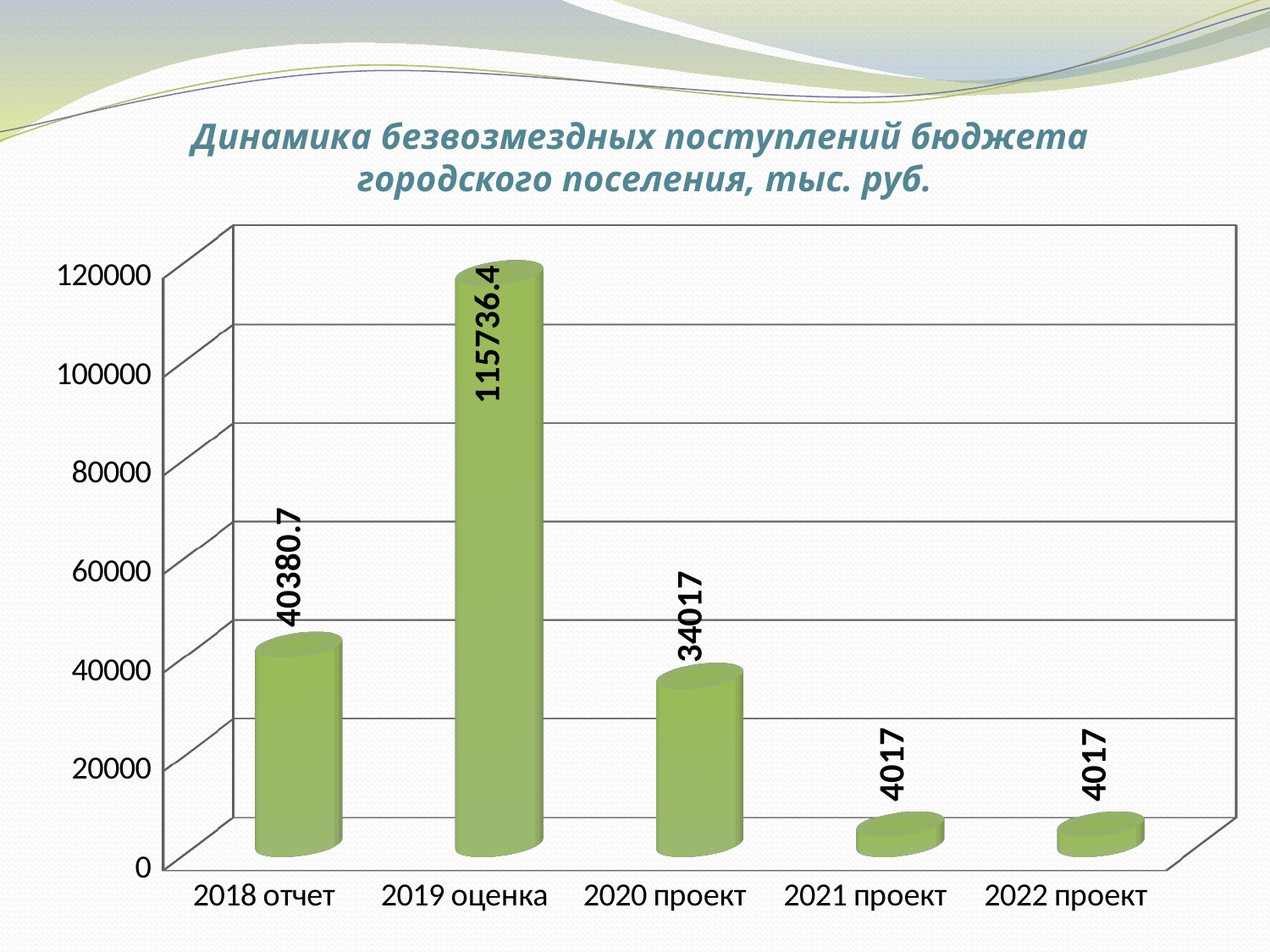
What is the title of the chart? Динамика безвозмездных поступлений бюджета городского поселения, тыс. руб. Which is larger, the value for 2018 отчет or the value for 2020 проект? 2018 отчет Is the value for 2019 оценка greater or less than 100000? greater What is the difference between the values for 2019 оценка and 2018 отчет? 75355.7 What is the value for 2020 проект? 34017 What is the value for 2021 проект? 4017 What is the value for 2018 отчет? 40380.7 What is the value for 2019 оценка? 115736.4 What kind of chart is shown on the slide? bar chart How many categories are shown on the x axis? 5 Which category has the highest value? 2019 оценка What is the difference between the values for 2020 проект and 2021 проект? 30000